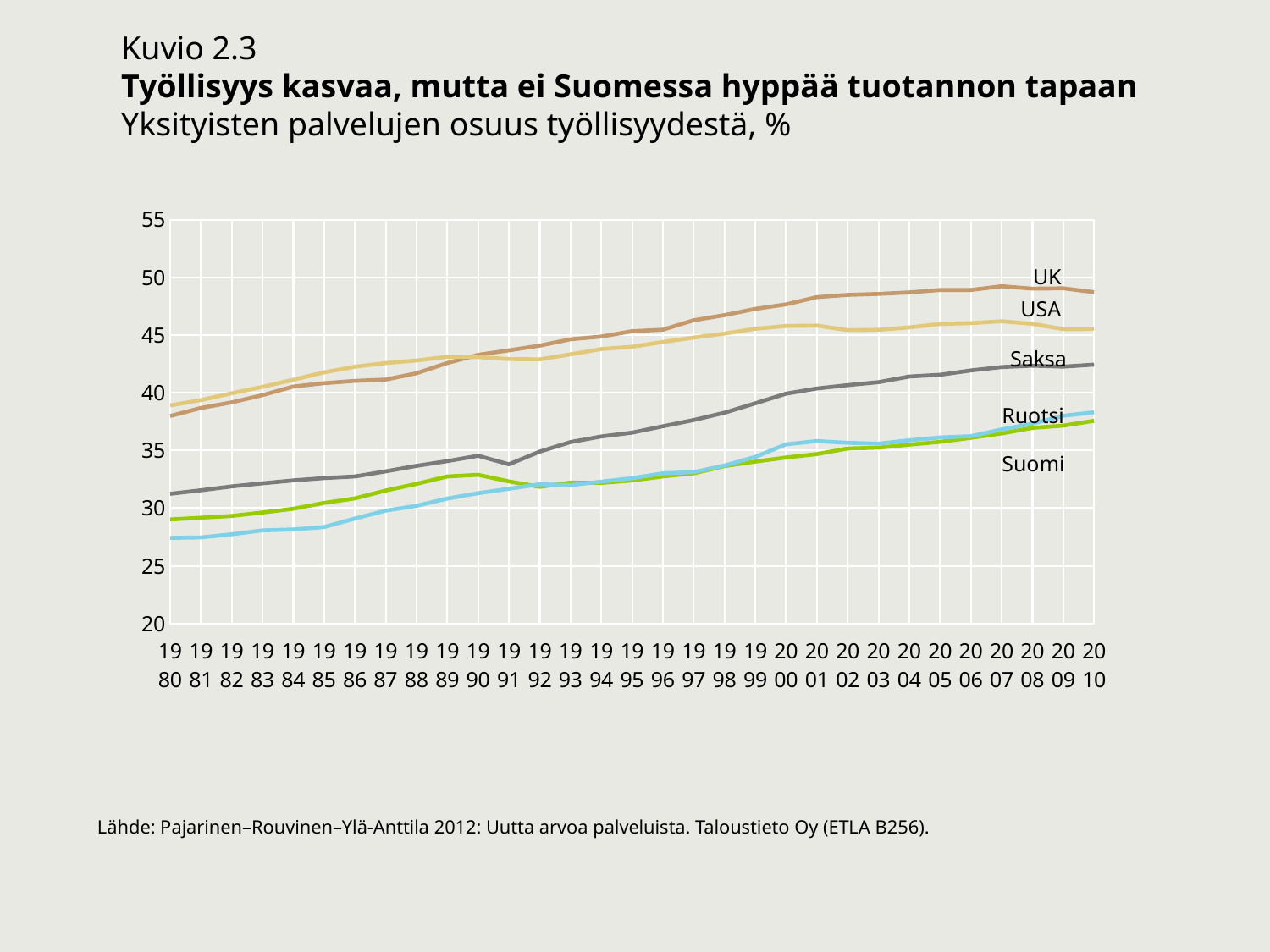
Is the value for Saksa in 1980 greater or less than 35? less Which country has the highest share of private services in employment in 2010? UK Does the UK line rise or fall from 1980 to 2010? rises How many countries (lines) are plotted in the chart? 5 What is the first year shown on the x axis? 1980 Which country has the lowest share of private services in employment in 1980? Ruotsi What kind of chart is shown on the slide? line chart How many years are shown on the x axis? 31 In 2010, which has a higher value, UK or USA? UK Is the value for UK in 2010 greater or less than 45? greater In 2010, which has a higher value, Saksa or Suomi? Saksa Is the value for Suomi in 2010 greater or less than 40? less